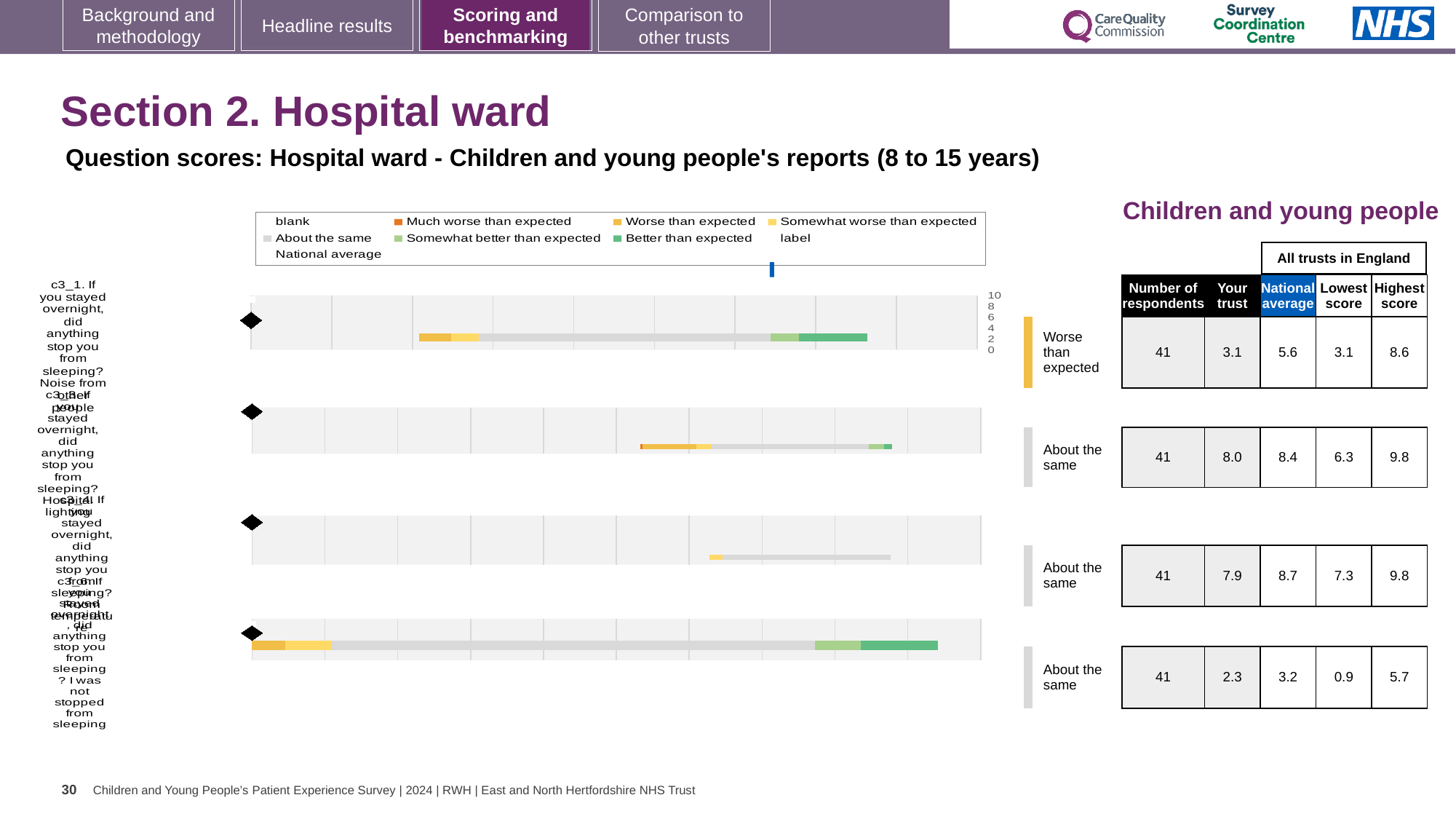
How many respondents are shown for the first question row? 41 Which question row has the lowest 'Your trust' score? the fourth row (c3_6) What kind of chart is used to show the question scores on this slide? bar chart How many question rows (bars) are plotted in the chart? 4 For the first question row, what is the difference between the national average and the 'Your trust' score? 2.5 What benchmark category is shown for the first question row? Worse than expected Which question row has the highest 'Your trust' score? the second row (c3_3) What is the maximum value shown on the chart's score axis? 10 Is the 'Your trust' score higher for the second question row or the third question row? the second row What is the 'Your trust' score for the first question row (c3_1, noise from other people)? 3.1 What is the highest score among all trusts in England for the fourth question row (c3_6)? 5.7 What is the national average for the second question row (c3_3)? 8.4